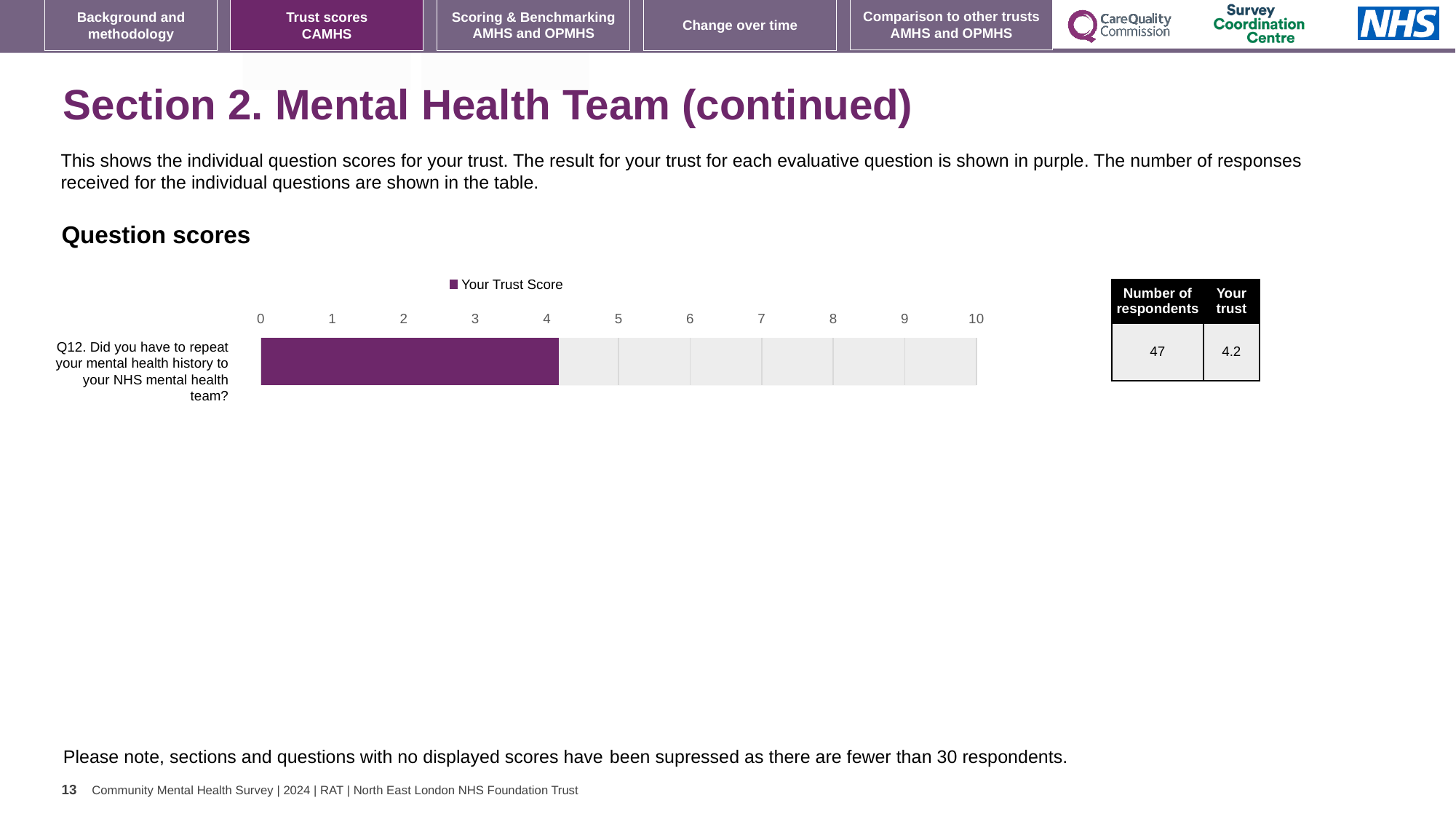
What is the maximum value shown on the x axis of the Question scores chart? 10 Is the bar for Q12 in the Question scores chart greater or less than 5? less How many questions (bars) are plotted in the Question scores chart? 1 What is the name of the series shown in the legend of the Question scores chart? Your Trust Score How many respondents answered Q12 according to the table next to the chart? 47 What is your trust's score for Q12 (Did you have to repeat your mental health history to your NHS mental health team?)? 4.2 How many series does the legend of the Question scores chart list? 1 What kind of chart is shown under "Question scores"? bar chart Is the bar for Q12 in the Question scores chart greater or less than 3? greater